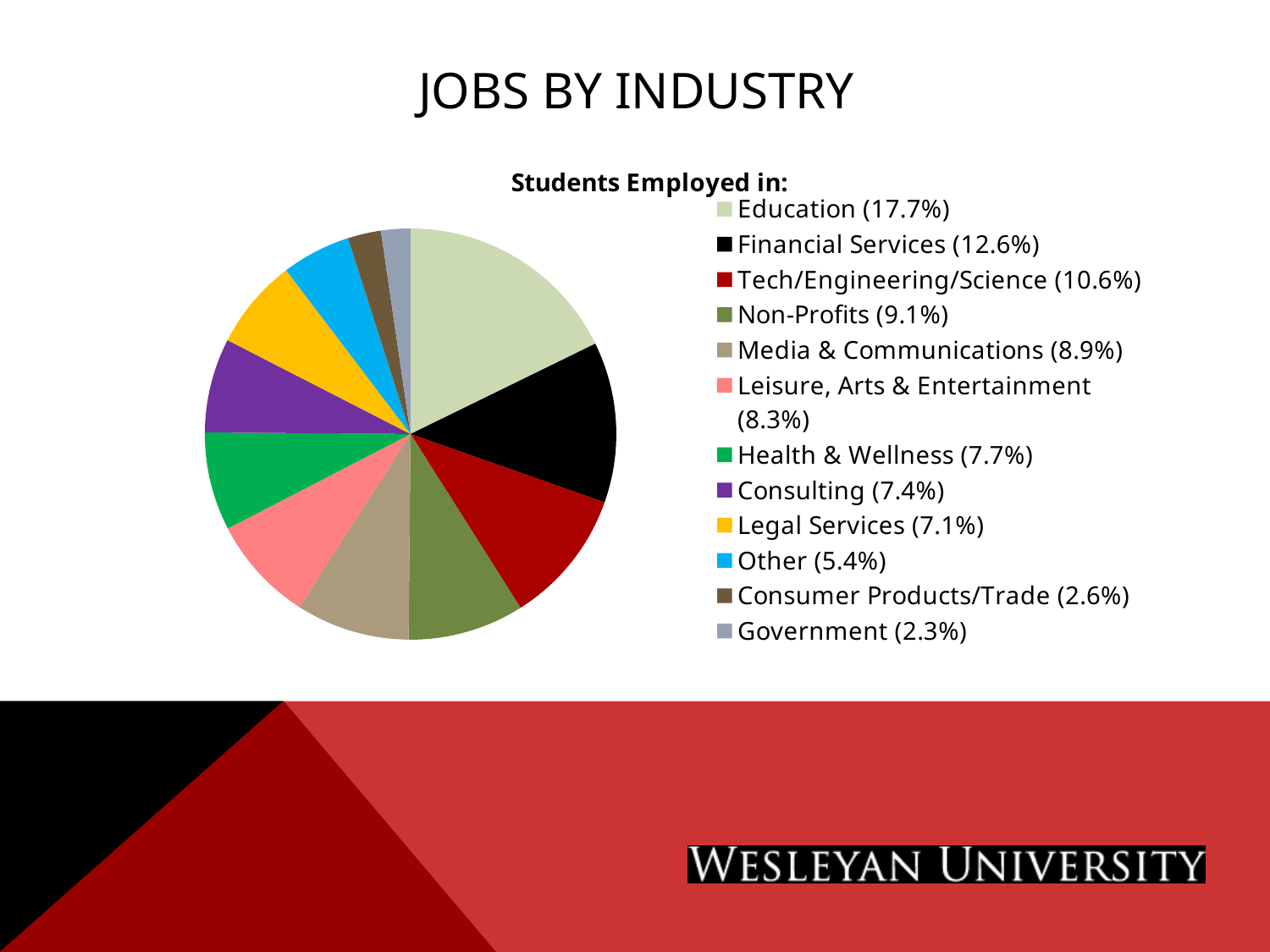
What percentage of students are employed in Legal Services? 7.1% How many categories does the pie chart have? 12 What is the difference in percentage points between Education and Financial Services? 5.1 What percentage of students are employed in Financial Services? 12.6% What is the difference in percentage points between Tech/Engineering/Science and Other? 5.2 What percentage of students are employed in Education? 17.7% What type of chart is shown on the slide? pie chart Which industry has the smallest share of students employed? Government What colour represents Health & Wellness in the legend? green Which has a larger share, Non-Profits or Consulting? Non-Profits Which industry has the largest share of students employed? Education What is the chart's title? Students Employed in: